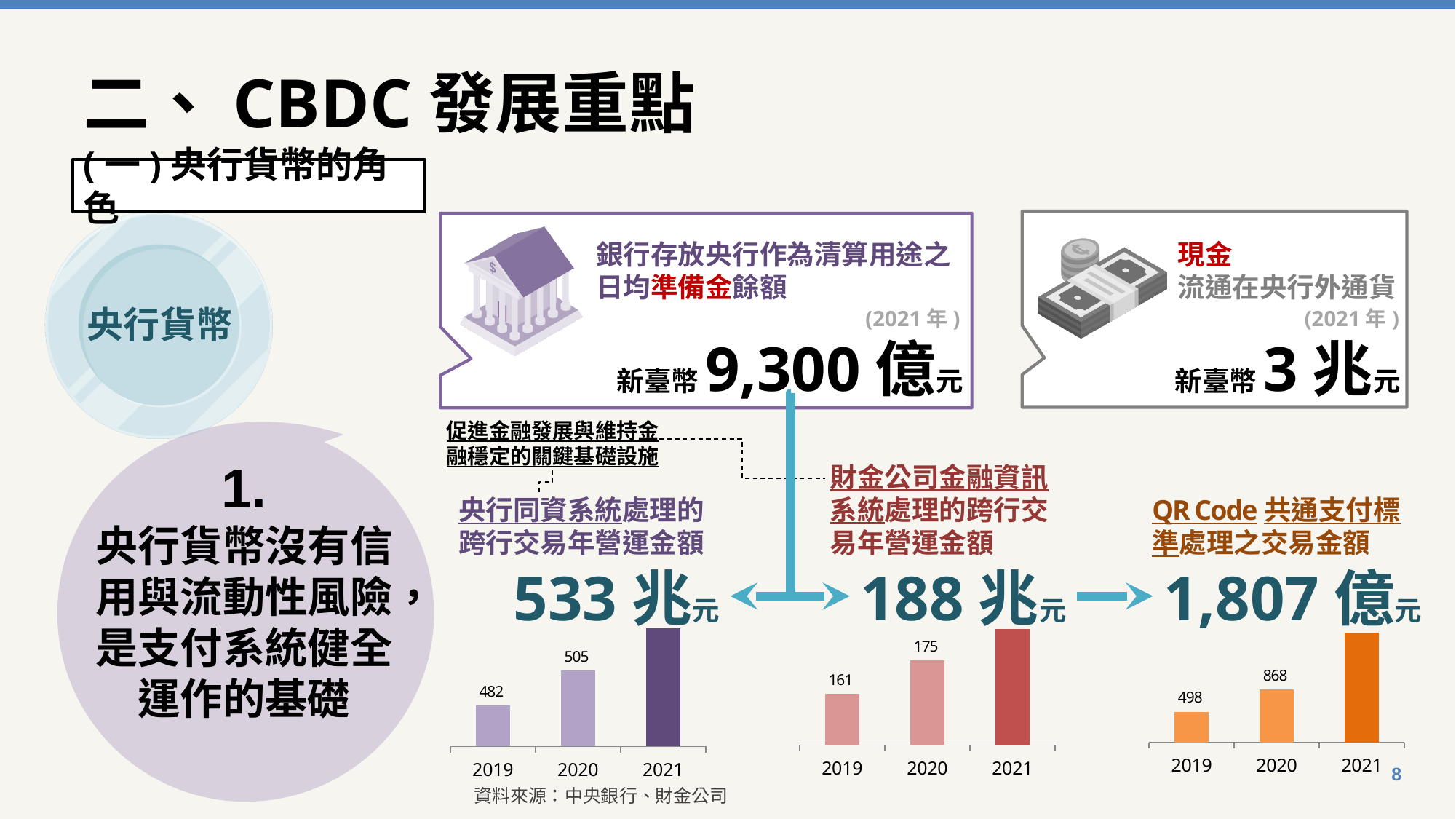
In the middle (red) bar chart, is the value for 2021 larger or smaller than the value for 2019? larger In the right (orange) bar chart, do the values rise or fall from 2019 to 2021? rise How many years are shown on the x axis of the left (purple) bar chart? 3 In the left (purple) bar chart, what is the value for 2020? 505 In the right (orange) bar chart, which year has the highest value? 2021 What kind of chart is the middle (red) chart? bar chart In the left (purple) bar chart, what is the difference between the 2020 and 2019 values? 23 In the middle (red) bar chart, what is the value for 2020? 175 In the right (orange) bar chart, what is the value for 2020? 868 In the left (purple) bar chart, what is the value for 2019? 482 In the middle (red) bar chart, which year has the lowest value? 2019 In the right (orange) bar chart, what is the difference between the 2020 and 2019 values? 370